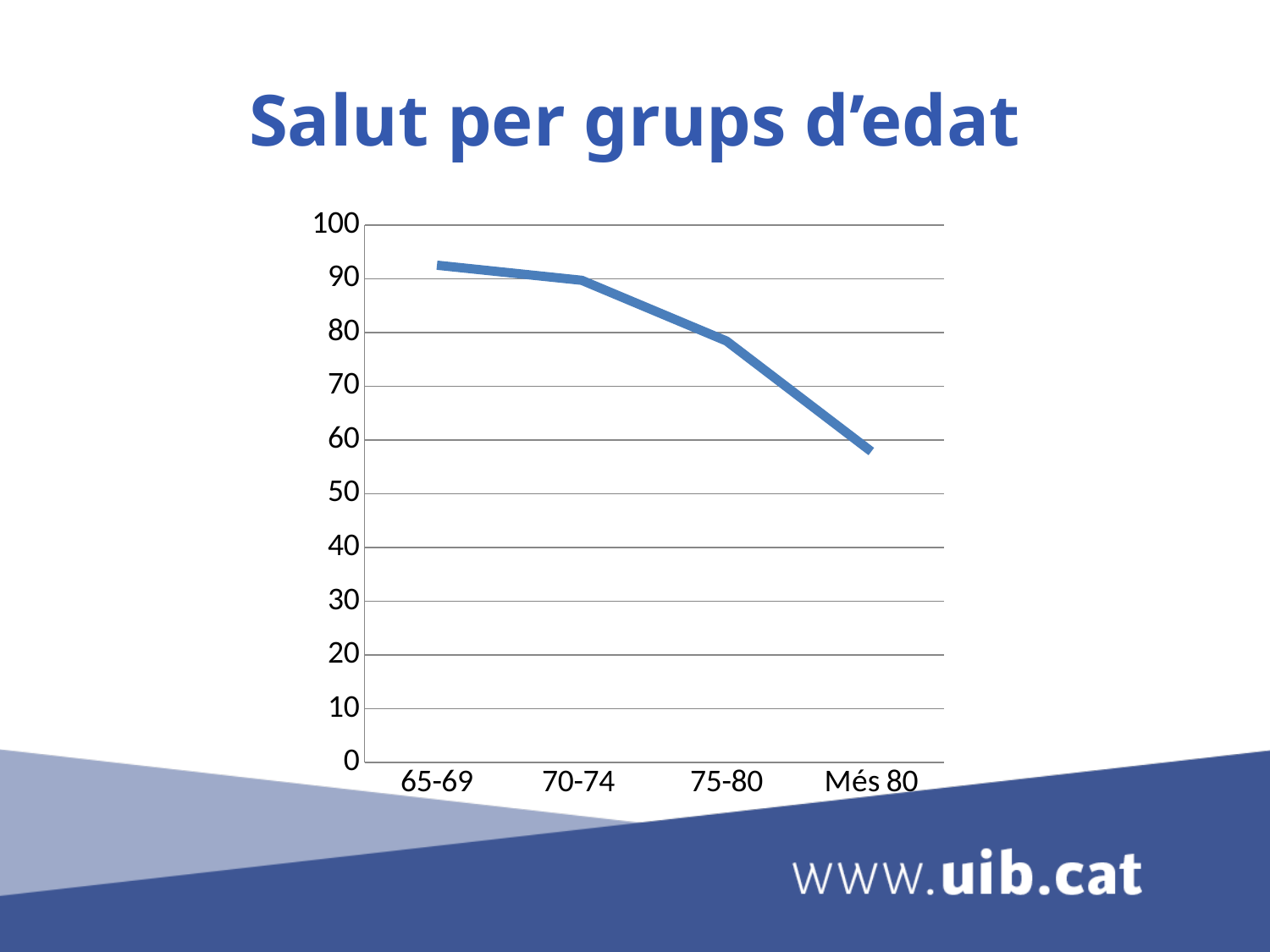
What kind of chart is shown on the slide? line chart Is the value for 75-80 greater or less than 70? greater Do the values rise or fall as the age groups increase along the x axis? fall Is the value for 70-74 greater or less than 80? greater Which has the larger value, 70-74 or 75-80? 70-74 How many age groups are plotted on the x axis? 4 What is the title of the chart? Salut per grups d'edat Is the value for Més 80 greater or less than 70? less What is the highest value shown on the y axis? 100 Which age group has the lowest value? Més 80 Which age group has the highest value? 65-69